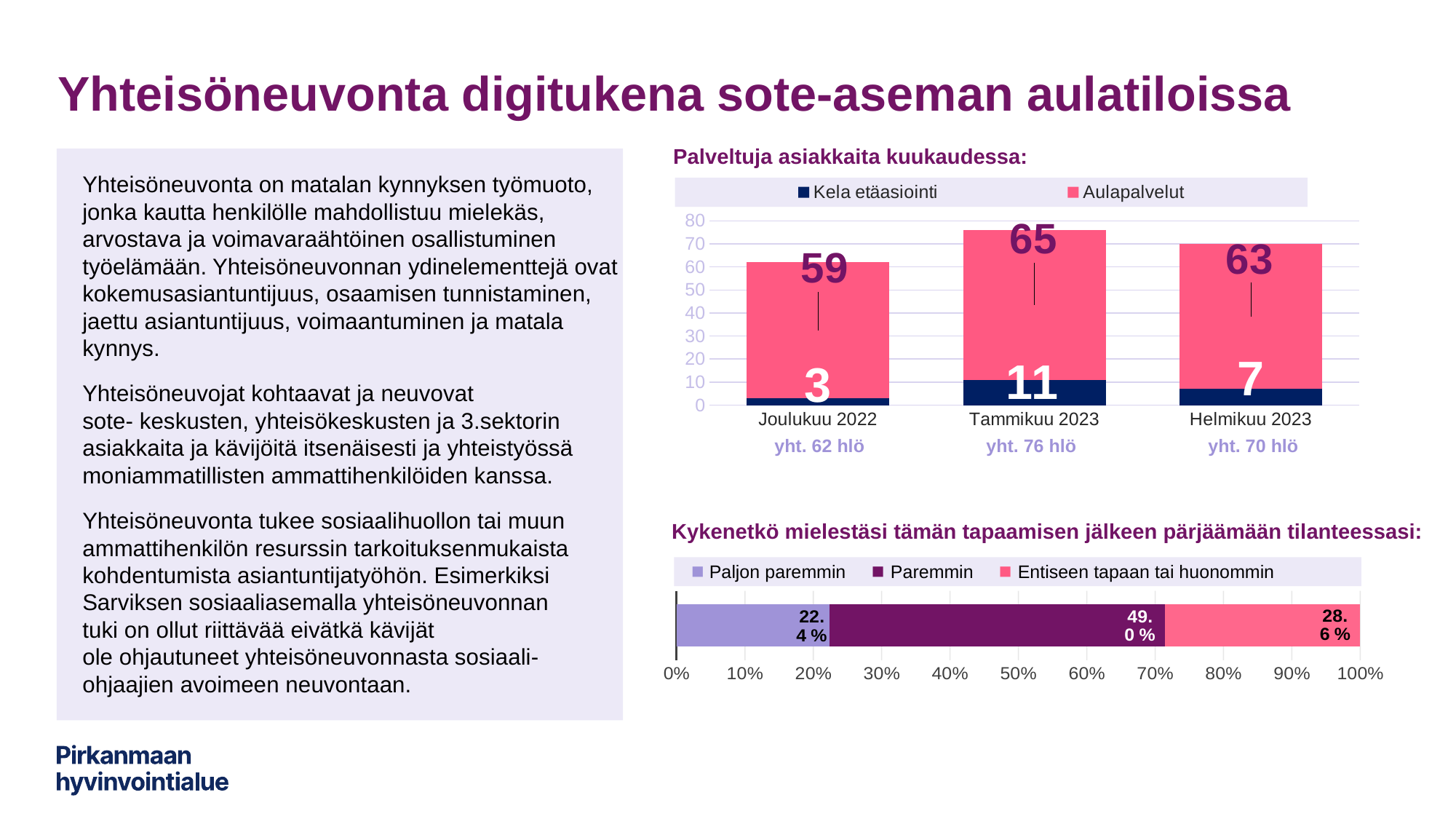
In the chart 'Palveltuja asiakkaita kuukaudessa', how many months are shown on the x axis? 3 In the chart 'Palveltuja asiakkaita kuukaudessa', what is the total of the stacked bar for Helmikuu 2023? 70 In the chart 'Palveltuja asiakkaita kuukaudessa', which month has the lowest Aulapalvelut value? Joulukuu 2022 In the chart 'Palveltuja asiakkaita kuukaudessa', which month has the highest Kela etäasiointi value? Tammikuu 2023 In the chart 'Palveltuja asiakkaita kuukaudessa', how many series does the legend list? 2 In the chart 'Palveltuja asiakkaita kuukaudessa', what is the difference between the Aulapalvelut values for Tammikuu 2023 and Joulukuu 2022? 6 In the chart 'Palveltuja asiakkaita kuukaudessa', what is the Kela etäasiointi value for Joulukuu 2022? 3 What kind of chart is 'Palveltuja asiakkaita kuukaudessa'? Stacked bar chart In the chart 'Palveltuja asiakkaita kuukaudessa', what is the Aulapalvelut value for Tammikuu 2023? 65 In the chart 'Kykenetkö mielestäsi tämän tapaamisen jälkeen pärjäämään tilanteessasi', how many categories does the legend list? 3 In the chart 'Kykenetkö mielestäsi tämän tapaamisen jälkeen pärjäämään tilanteessasi', what is the value for Paremmin? 49.0 % In the chart 'Kykenetkö mielestäsi tämän tapaamisen jälkeen pärjäämään tilanteessasi', which of Paljon paremmin and Entiseen tapaan tai huonommin has the larger value? Entiseen tapaan tai huonommin